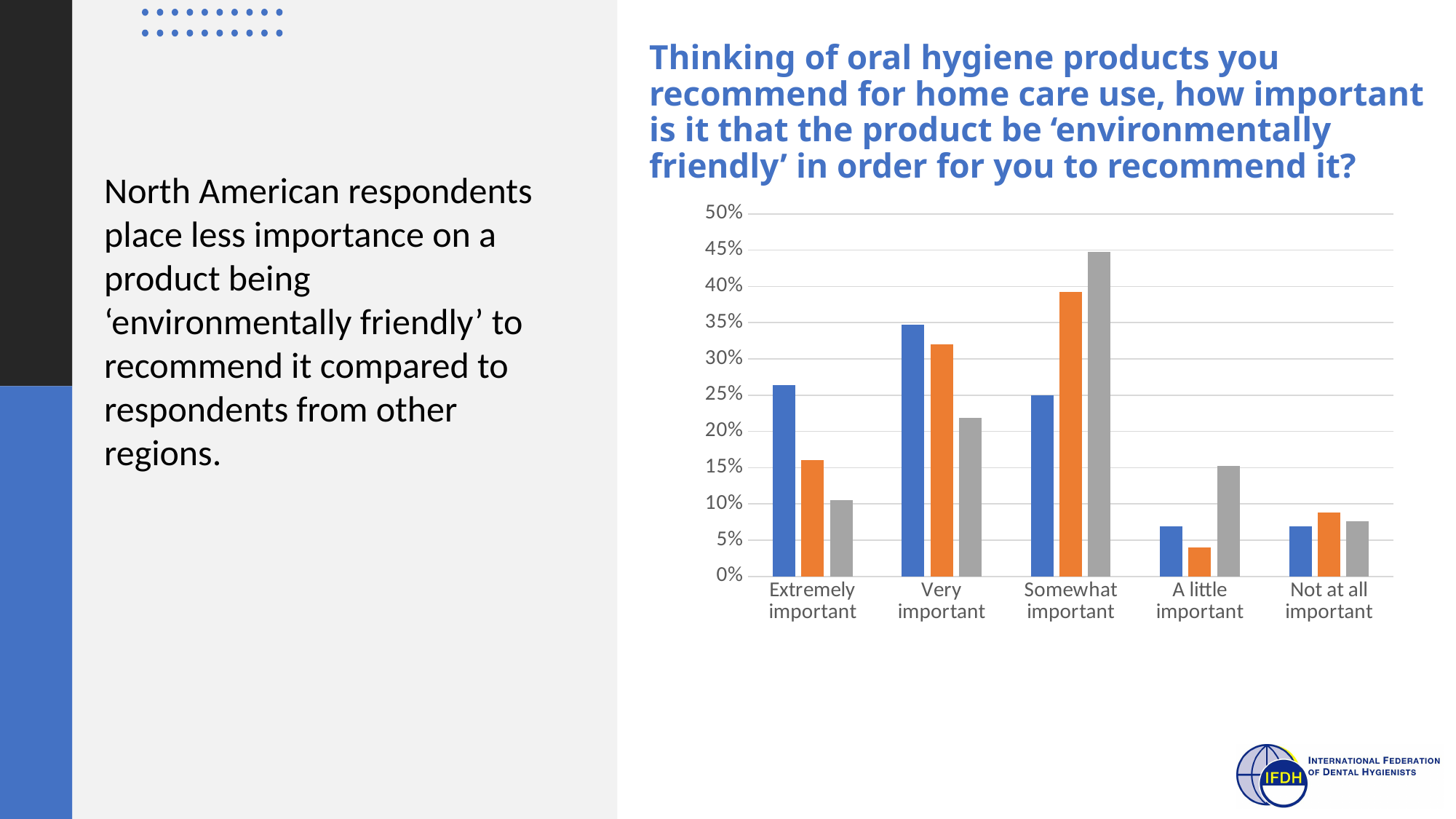
Is the value of the grey bar for 'Somewhat important' greater or less than 40%? greater Is the value of the blue bar for 'Extremely important' greater or less than 20%? greater Is the value of the orange bar for 'A little important' greater or less than 10%? less What kind of chart is shown on the slide? bar chart How many categories are shown on the x axis of the chart? 5 In which category is the blue bar the tallest? Very important For 'Somewhat important', which is larger: the blue bar or the orange bar? the orange bar How many bars are plotted for each category in the chart? 3 In which category is the grey bar the tallest? Somewhat important For 'Extremely important', which is larger: the blue bar or the grey bar? the blue bar Do the grey bars rise or fall from 'Extremely important' to 'Somewhat important'? rise